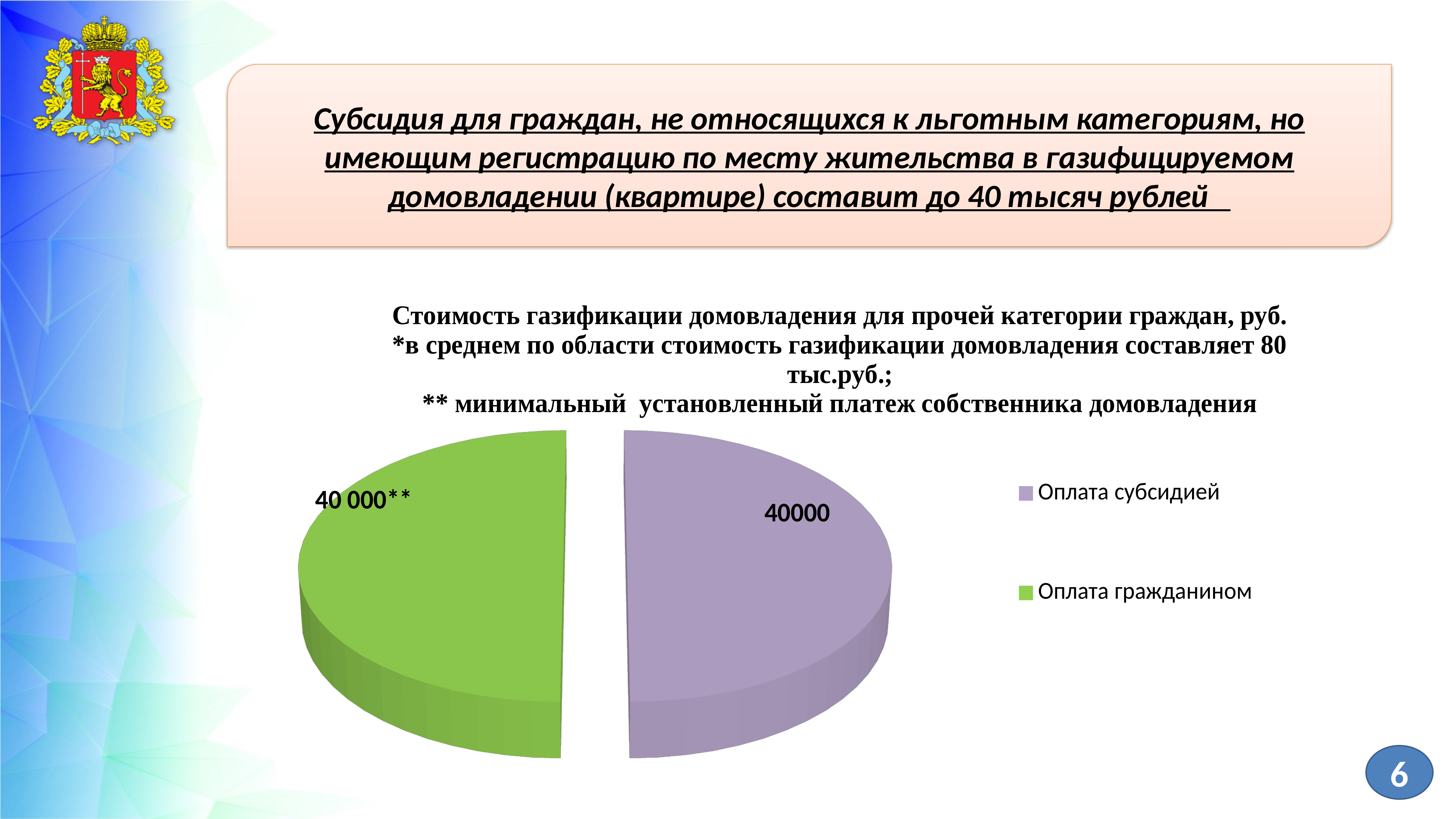
What share of the pie does the "Оплата гражданином" slice represent? 50% What kind of chart is shown on the slide? pie chart What value is shown for the "Оплата гражданином" slice? 40 000** How many slices does the pie chart have? 2 What is the total of the two slices in the pie chart? 80000 What is the difference between the "Оплата субсидией" and "Оплата гражданином" values? 0 Which colour represents "Оплата субсидией" in the pie chart? purple What share of the pie does the "Оплата субсидией" slice represent? 50% How many entries does the legend of the pie chart list? 2 What value is shown for the "Оплата субсидией" slice? 40000 Which colour represents "Оплата гражданином" in the pie chart? green